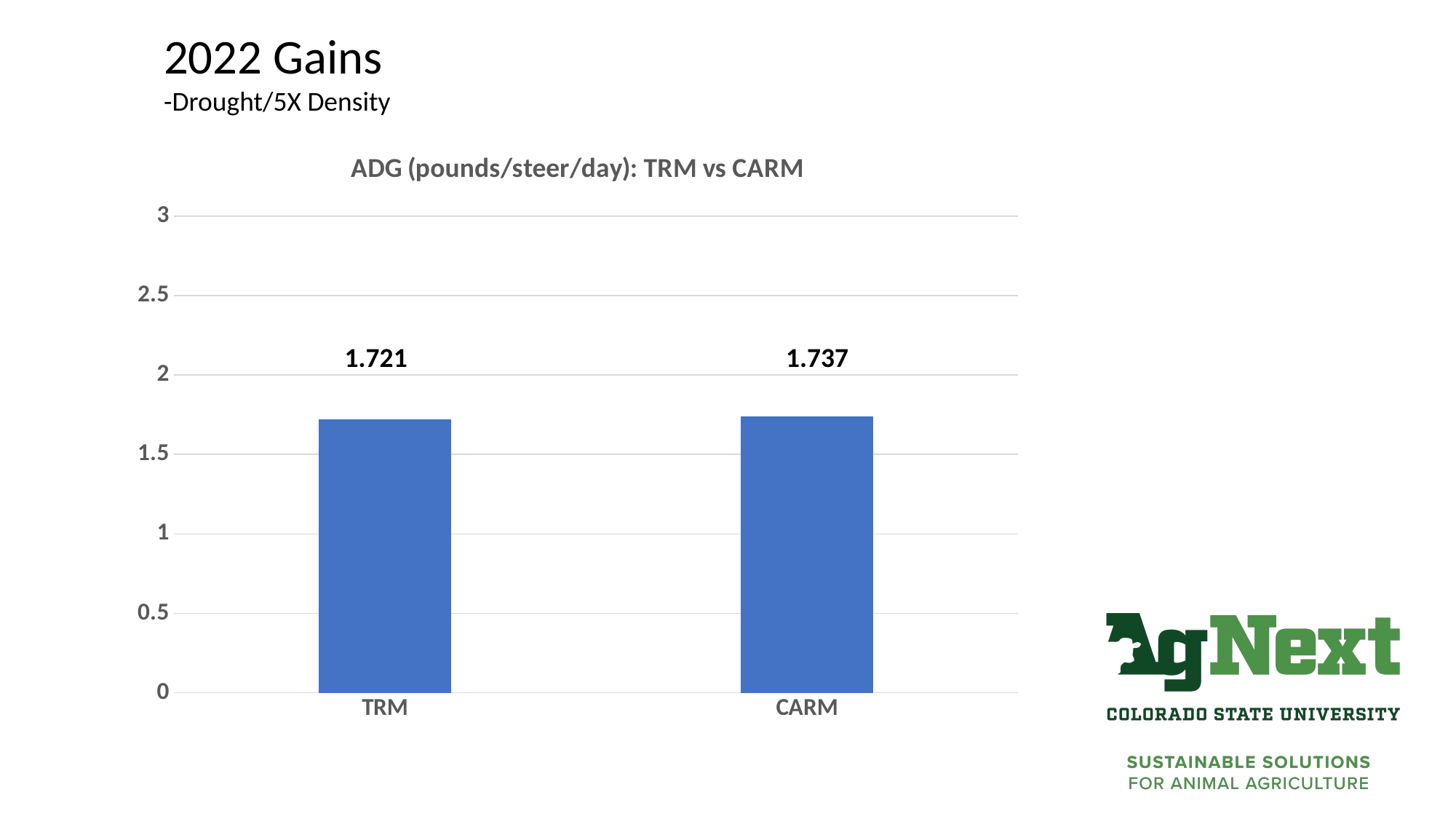
How many categories are shown on the chart? 2 What is the maximum value shown on the vertical axis? 3 What is the ADG value for TRM? 1.721 Which category has the higher ADG, TRM or CARM? CARM What kind of chart is shown on the slide? Bar chart What is the difference in ADG between CARM and TRM? 0.016 Is the ADG value for TRM greater or less than 2? less What is the title of the chart? ADG (pounds/steer/day): TRM vs CARM Which category has the lowest ADG? TRM What is the ADG value for CARM? 1.737 Is the ADG value for CARM greater or less than 1.5? greater Which category has the highest ADG? CARM